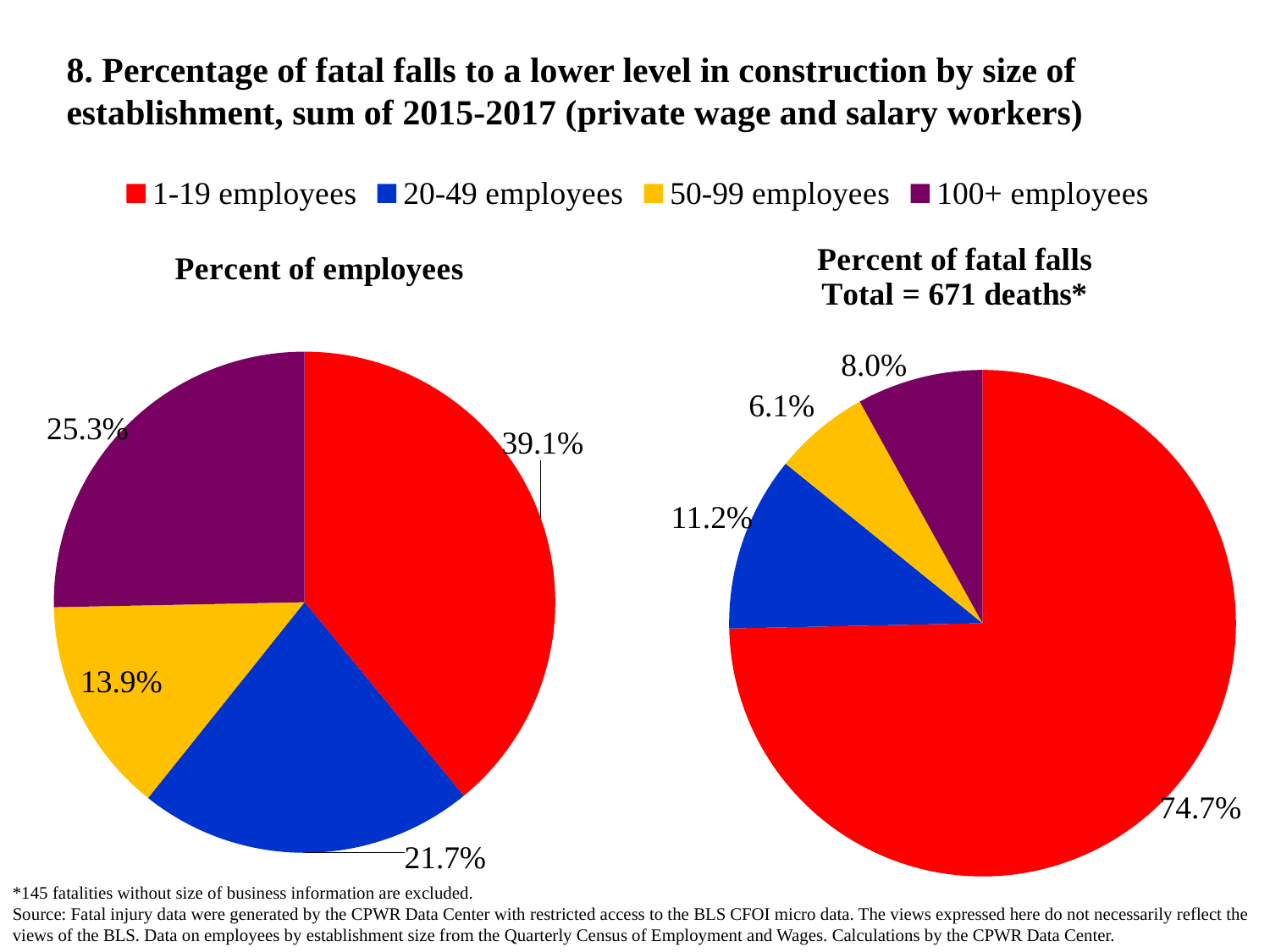
How many slices does the 'Percent of fatal falls' pie chart have? 4 In the 'Percent of fatal falls' pie chart, what is the value for 1-19 employees? 74.7% In the 'Percent of employees' pie chart, what is the difference between the 100+ employees share and the 20-49 employees share? 3.6% In the 'Percent of employees' pie chart, what is the value for 1-19 employees? 39.1% What type of chart is used on this slide? Pie chart What total number of deaths is stated in the title of the 'Percent of fatal falls' chart? 671 In the 'Percent of employees' pie chart, which establishment size has the largest share? 1-19 employees In the 'Percent of fatal falls' pie chart, what is the value for 20-49 employees? 11.2% In the 'Percent of fatal falls' pie chart, which establishment size has the smallest share? 50-99 employees Which is larger: the 100+ employees share in the 'Percent of employees' chart or the 100+ employees share in the 'Percent of fatal falls' chart? Percent of employees In the 'Percent of employees' pie chart, what is the value for 50-99 employees? 13.9% In the 'Percent of fatal falls' pie chart, what is the difference between the 1-19 employees share and the 100+ employees share? 66.7%